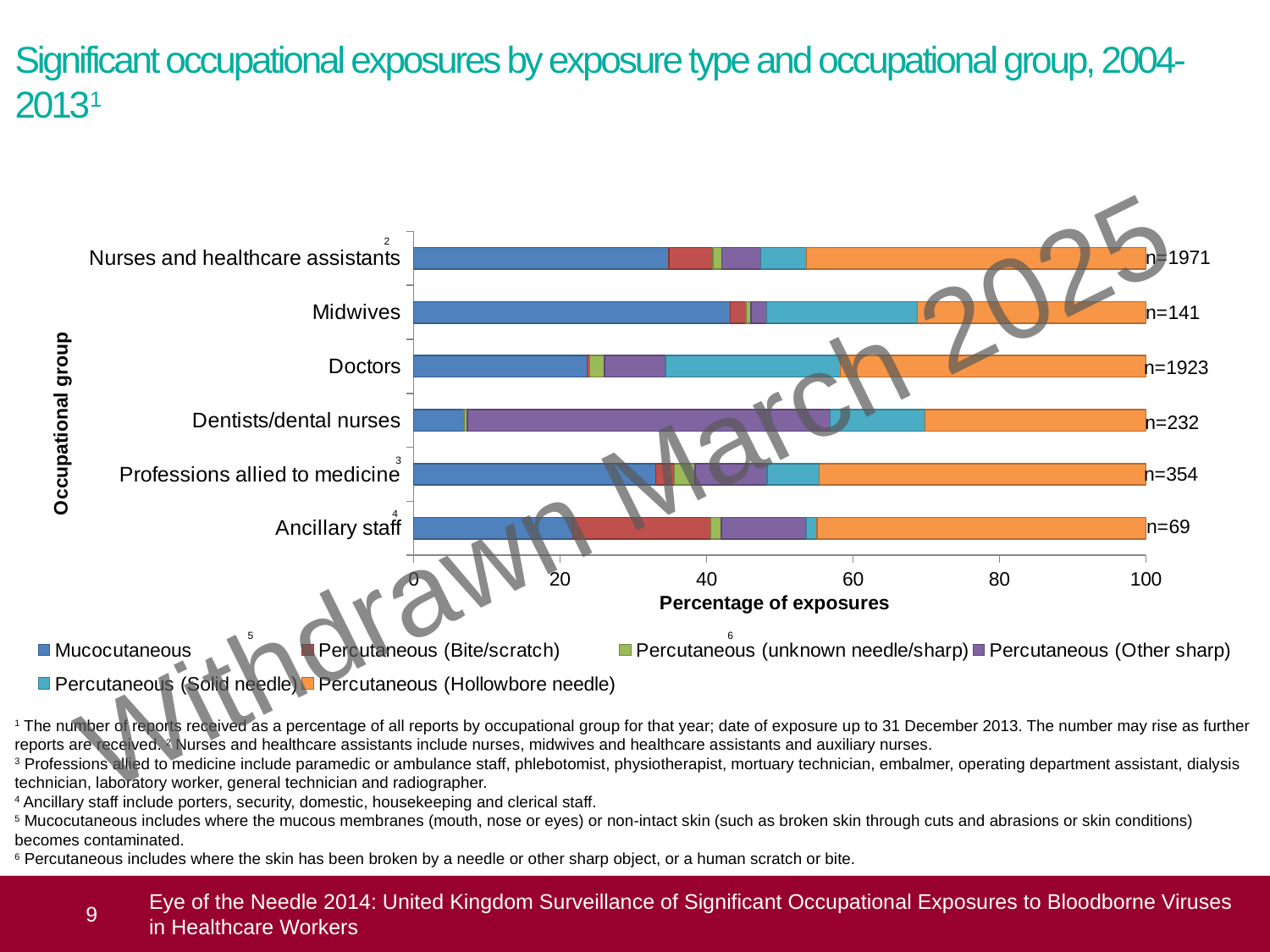
What is the n value shown for Nurses and healthcare assistants? n=1971 What is the n value shown for Dentists/dental nurses? n=232 What is the n value shown for Ancillary staff? n=69 Is the Mucocutaneous percentage for Nurses and healthcare assistants greater or less than 20? greater What kind of chart is shown on the slide? Stacked bar chart Is the Mucocutaneous percentage for Dentists/dental nurses greater or less than 20? less How many occupational groups are plotted on the chart? 6 Which occupational group has the largest Percutaneous (Other sharp) share? Dentists/dental nurses What is the title of the horizontal axis? Percentage of exposures Which occupational group has the smallest n value? Ancillary staff How many exposure types does the legend list? 6 What is the difference between the n values for Nurses and healthcare assistants and Doctors? 48